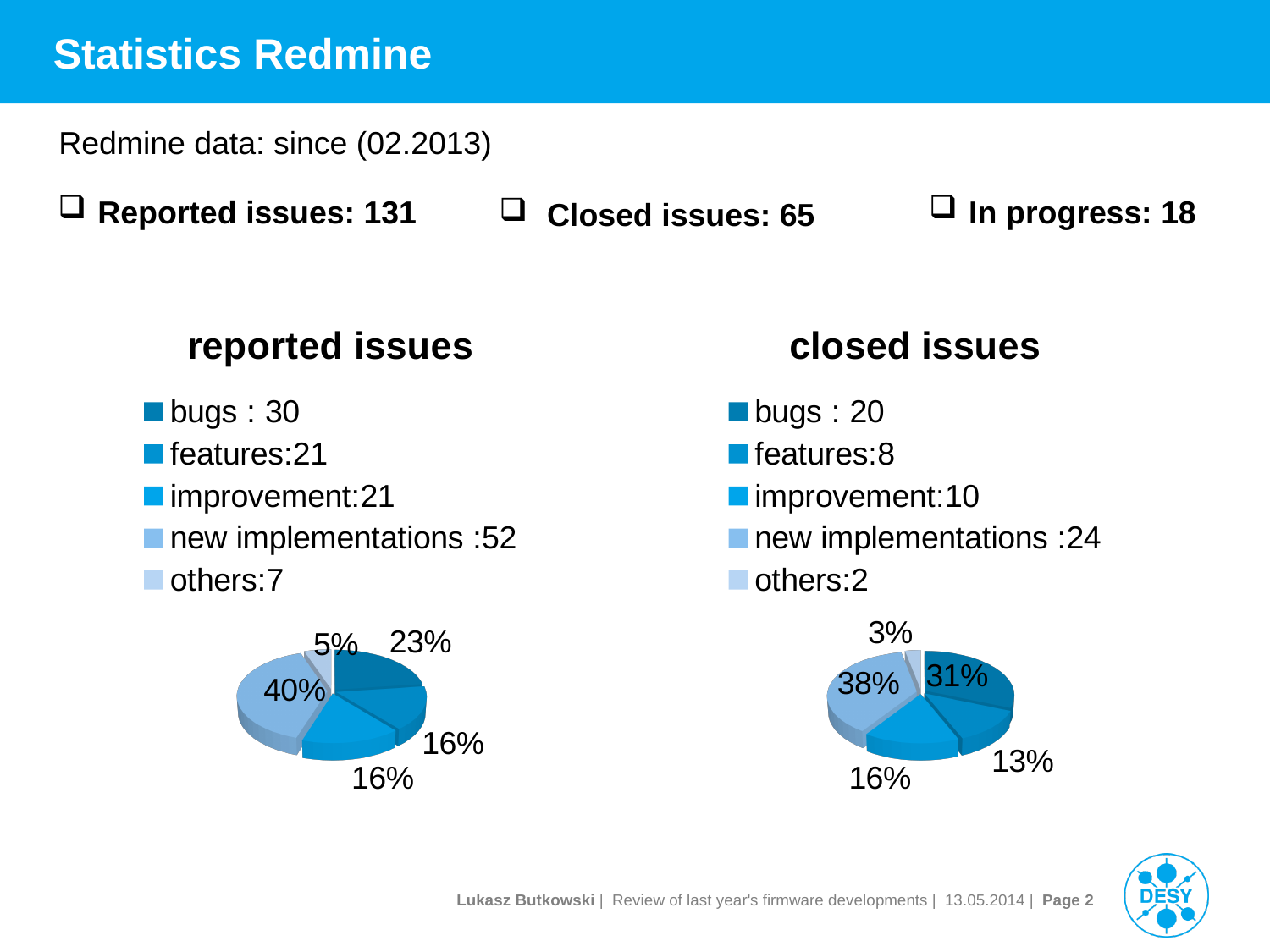
What kind of chart is the "reported issues" chart? pie chart In the "reported issues" chart, how many issues are listed for bugs? 30 In the "reported issues" chart, what is the difference between the number of new implementations and the number of bugs? 22 In the "reported issues" chart, how many issues are listed for new implementations? 52 How many categories does the "closed issues" chart show? 5 In the "closed issues" chart, which category has the largest number of issues? new implementations In the "closed issues" chart, how many issues are listed for improvement? 10 In the "closed issues" chart, what share of the pie do bugs take? 31% In the "reported issues" chart, what share of the pie do new implementations take? 40% In the "reported issues" chart, which category has the smallest number of issues? others In the "closed issues" chart, what is the difference between the number of new implementations and the number of others? 22 In the "closed issues" chart, which is larger: bugs or features? bugs